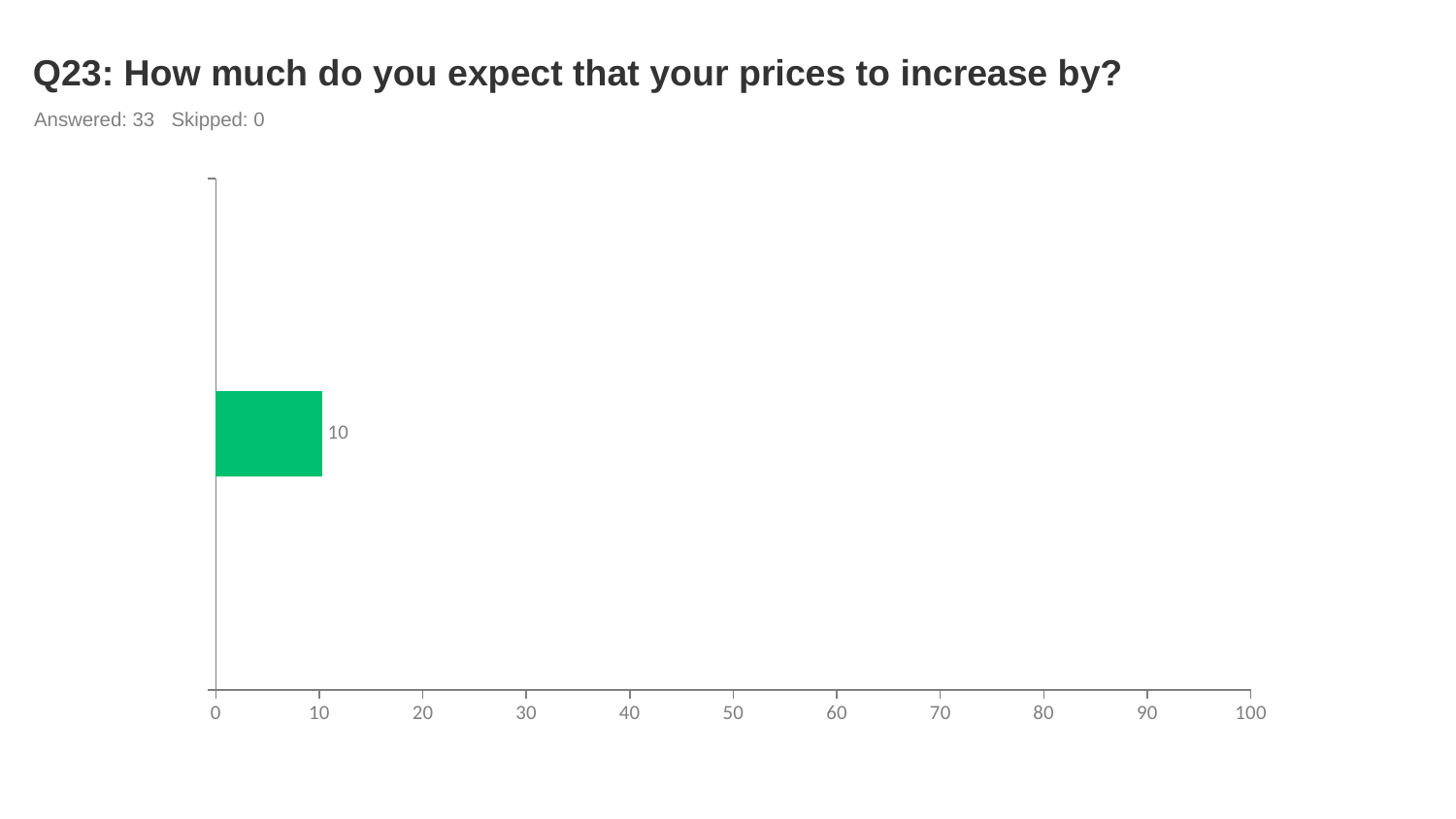
How many bars are plotted in the chart? 1 Is the value of the bar greater or less than 20? less What is the highest tick value shown on the x axis? 100 What kind of chart is shown on the slide? bar chart What is the title of the chart? Q23: How much do you expect that your prices to increase by? What value is printed as the data label on the bar? 10 Is the value of the bar greater or less than 50? less